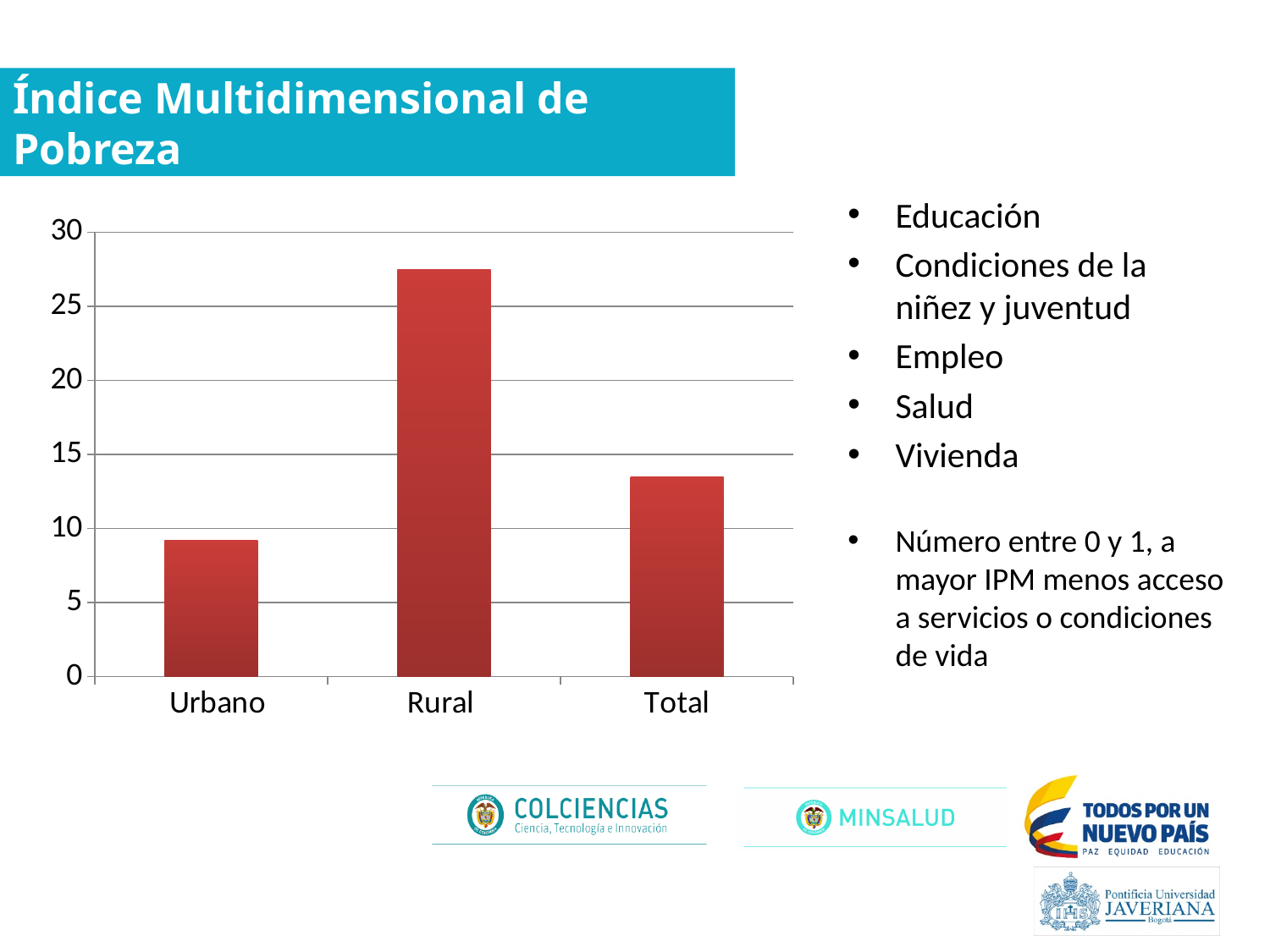
How many categories are shown on the x axis of the chart? 3 Which is larger, the value for Total or the value for Urbano? Total Is the value for Urbano greater or less than 10? less What is the highest value shown on the y axis of the chart? 30 Which category has the highest bar in the chart? Rural Which is larger, the value for Rural or the value for Total? Rural Is the value for Rural greater or less than 25? greater What kind of chart is shown on the slide? bar chart Which category has the lowest bar in the chart? Urbano What is the title shown above the chart on the slide? Índice Multidimensional de Pobreza Is the value for Total greater or less than 10? greater